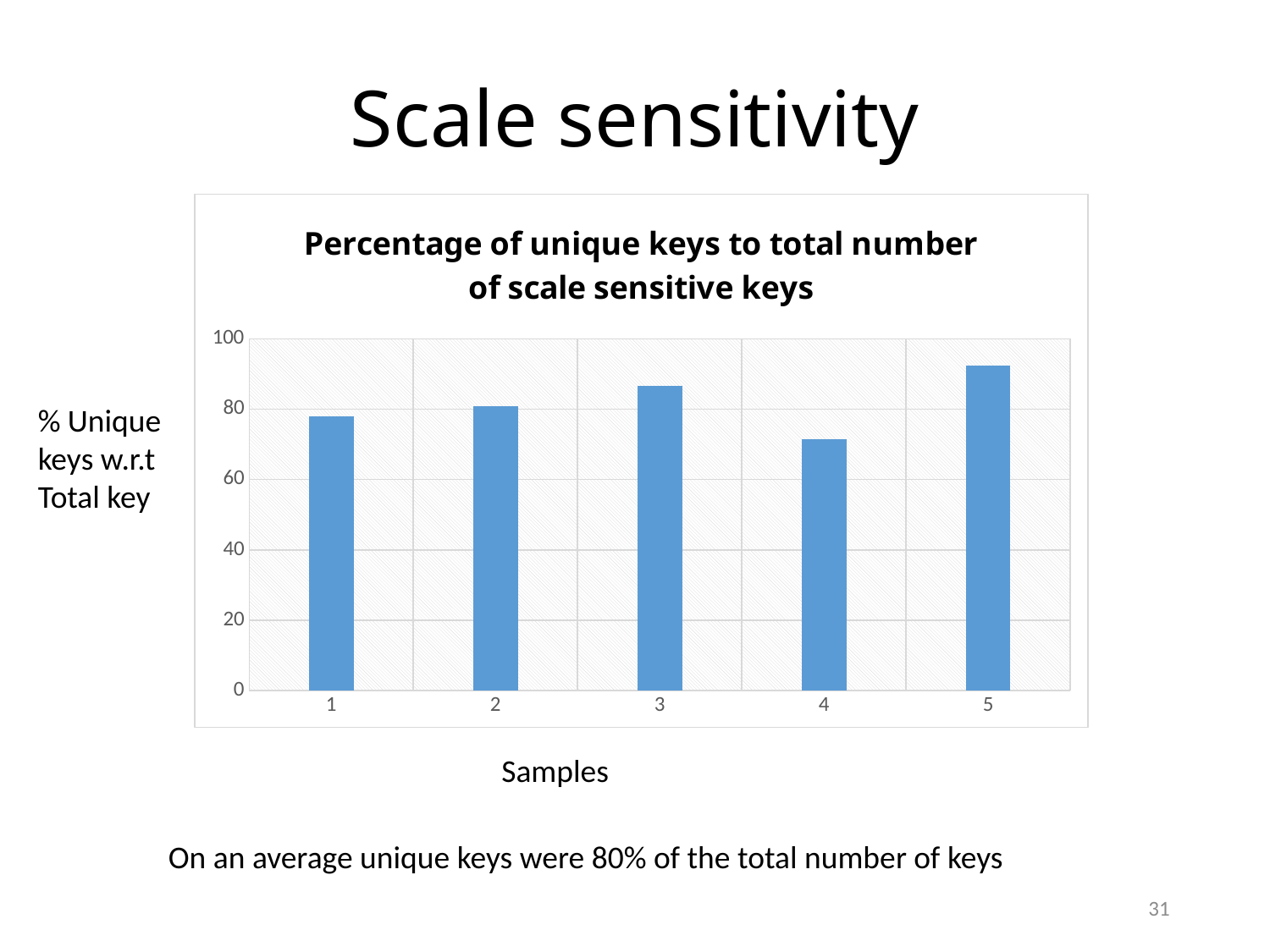
What is the title of the chart? Percentage of unique keys to total number of scale sensitive keys Which sample has a higher bar, sample 3 or sample 4? 3 Which sample has a higher bar, sample 1 or sample 5? 5 What kind of chart is shown on the slide? bar chart What label is given to the x axis of the chart? Samples Which sample has the lowest percentage of unique keys? 4 Which sample has the highest percentage of unique keys? 5 Is the value for sample 4 greater or less than 80? less Is the value for sample 1 greater or less than 60? greater Is the value for sample 5 greater or less than 80? greater How many samples are plotted on the x axis of the chart? 5